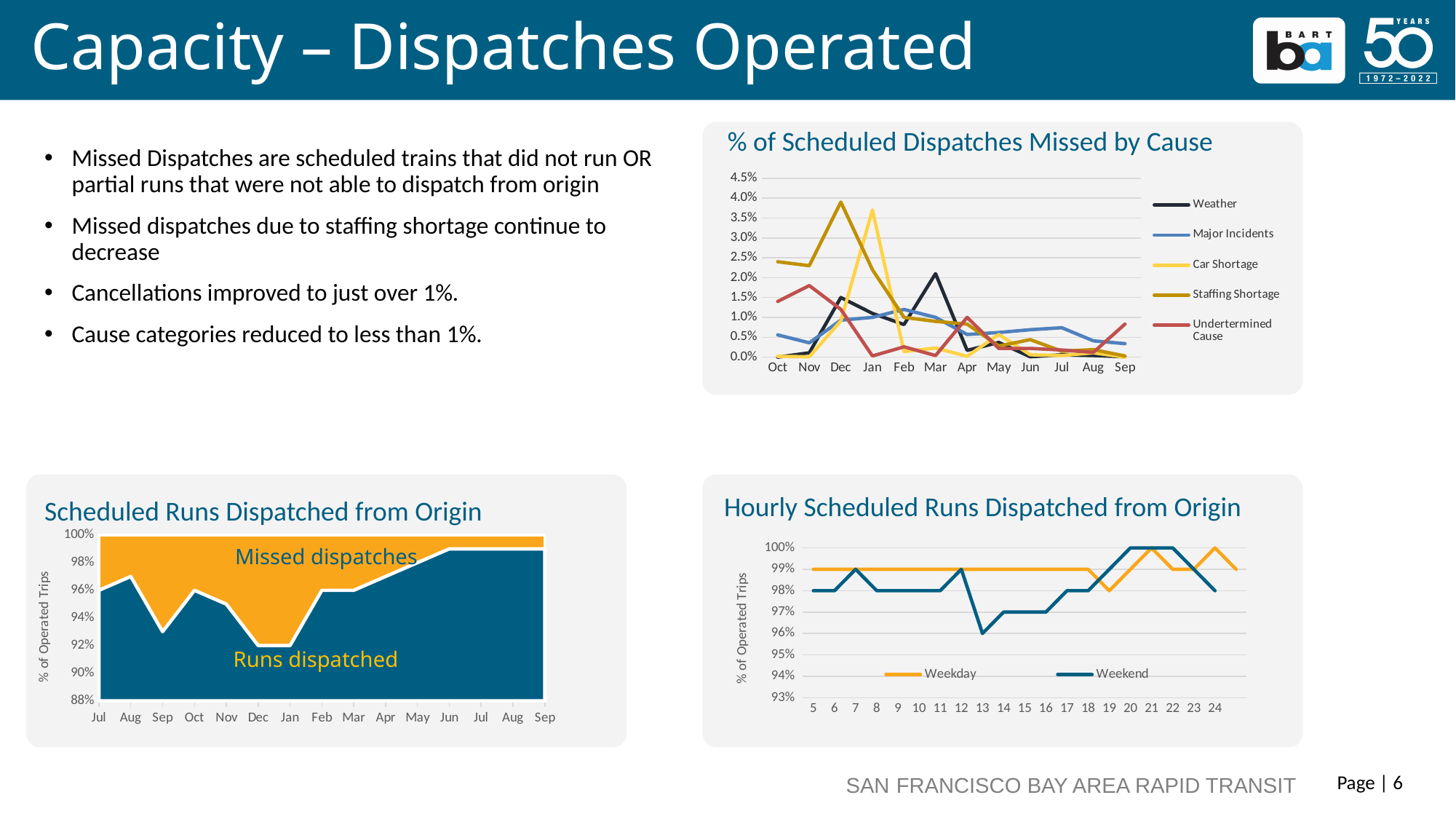
How many months are shown on the x axis of '% of Scheduled Dispatches Missed by Cause'? 12 In 'Hourly Scheduled Runs Dispatched from Origin', what is the Weekend value at hour 13? 96% In 'Scheduled Runs Dispatched from Origin', is the Runs dispatched value for Jan greater or less than 94%? less How many series does the legend of '% of Scheduled Dispatches Missed by Cause' list? 5 In 'Hourly Scheduled Runs Dispatched from Origin', what is the Weekday value at hour 21? 100% In '% of Scheduled Dispatches Missed by Cause', is the Staffing Shortage value for Dec greater or less than 3.0%? greater In 'Scheduled Runs Dispatched from Origin', does the Runs dispatched share rise or fall from Jan to Jun? Rise In '% of Scheduled Dispatches Missed by Cause', which cause has the highest value in Jan? Car Shortage In '% of Scheduled Dispatches Missed by Cause', which cause has the highest value in Dec? Staffing Shortage What kind of chart is '% of Scheduled Dispatches Missed by Cause'? Line chart In 'Hourly Scheduled Runs Dispatched from Origin', which series has the larger value at hour 24, Weekday or Weekend? Weekday In '% of Scheduled Dispatches Missed by Cause', is the Weather value for Mar greater or less than 1.5%? greater